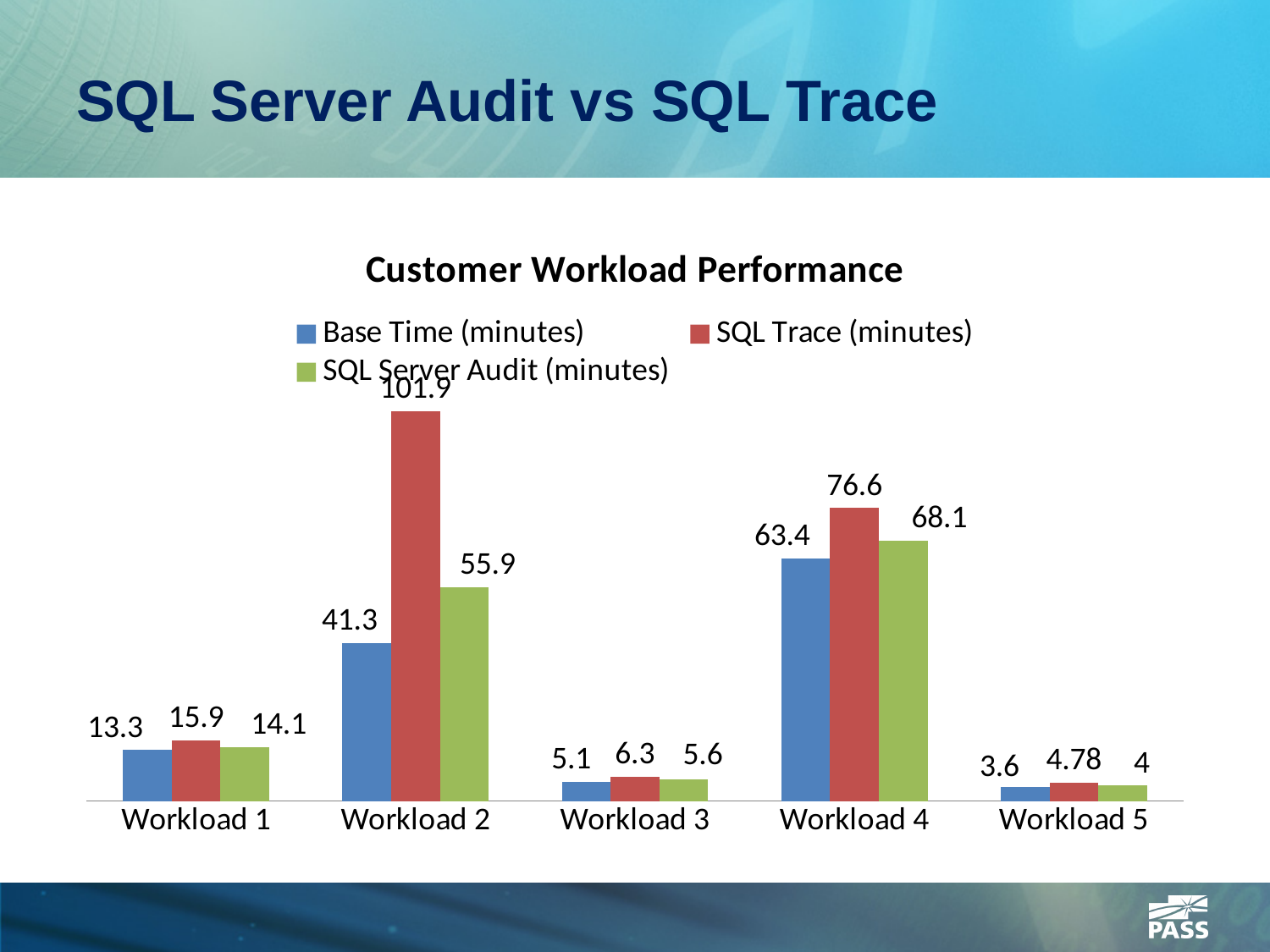
What is the difference between the SQL Trace (minutes) and SQL Server Audit (minutes) values for Workload 2? 46 What is the SQL Trace (minutes) value for Workload 2? 101.9 What is the SQL Server Audit (minutes) value for Workload 5? 4 What is the Base Time (minutes) value for Workload 4? 63.4 Which is larger for Workload 1: the SQL Trace (minutes) value or the SQL Server Audit (minutes) value? SQL Trace (minutes) What kind of chart is shown on the slide? Bar chart How many series does the legend list? 3 What is the title of the chart? Customer Workload Performance Which workload has the highest SQL Trace (minutes) value? Workload 2 How many workloads are shown on the x axis? 5 Which workload has the lowest Base Time (minutes) value? Workload 5 What is the difference between the SQL Trace (minutes) and Base Time (minutes) values for Workload 4? 13.2